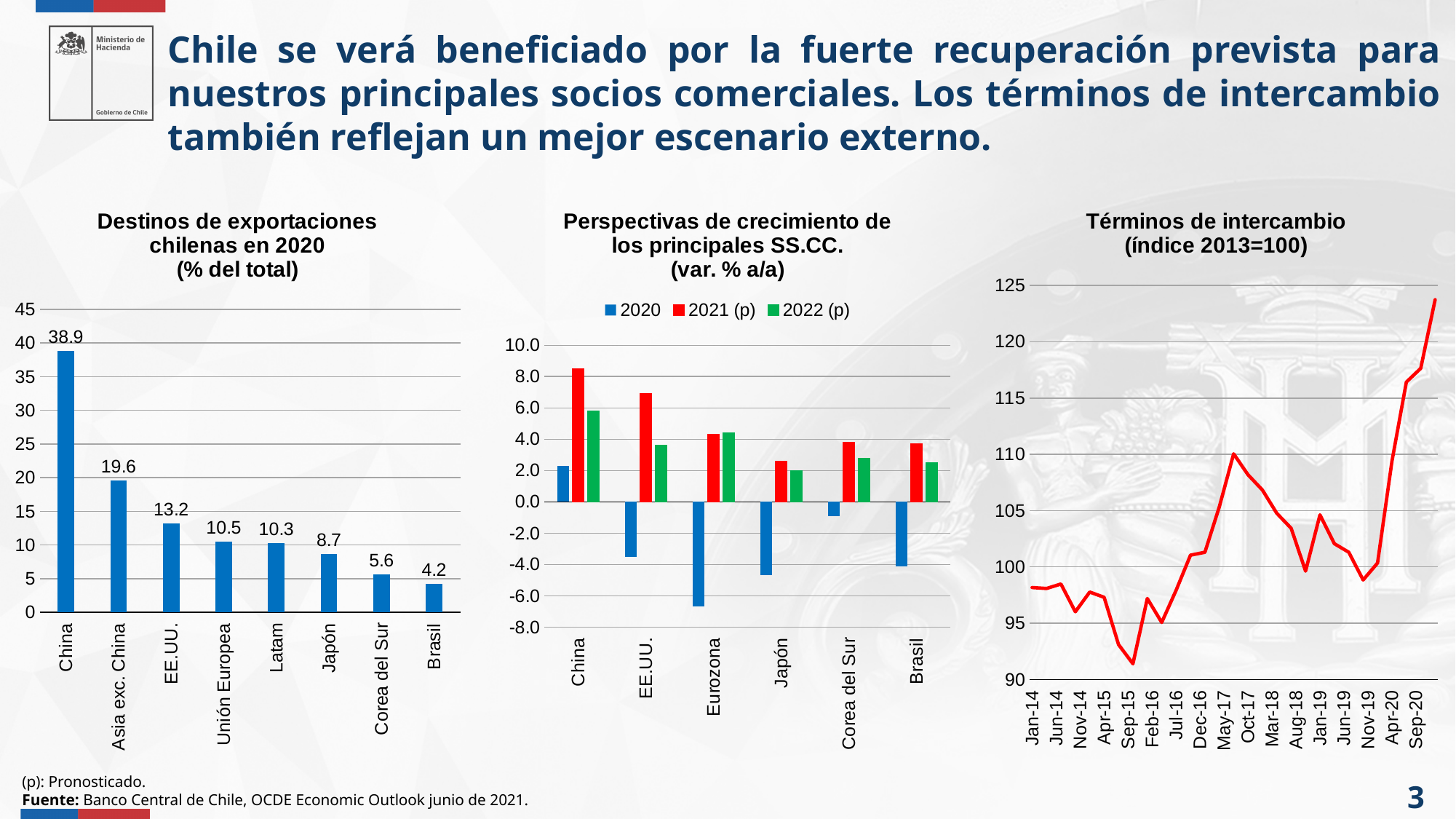
In the 'Perspectivas de crecimiento de los principales SS.CC.' chart, how many series does the legend list? 3 In the 'Destinos de exportaciones chilenas en 2020' chart, how many categories are shown? 8 In the 'Destinos de exportaciones chilenas en 2020' chart, what is the value for China? 38.9 In the 'Destinos de exportaciones chilenas en 2020' chart, which category has the lowest value? Brasil In the 'Destinos de exportaciones chilenas en 2020' chart, which is larger, the value for EE.UU. or the value for Latam? EE.UU. In the 'Perspectivas de crecimiento de los principales SS.CC.' chart, which category has the lowest 2020 value? Eurozona In the 'Destinos de exportaciones chilenas en 2020' chart, what is the difference between the values for China and Asia exc. China? 19.3 In the 'Términos de intercambio' chart, is the value at Sep-20 greater or less than 120? less In the 'Destinos de exportaciones chilenas en 2020' chart, what is the value for Japón? 8.7 In the 'Perspectivas de crecimiento de los principales SS.CC.' chart, is the 2020 value for Eurozona greater or less than -6.0? less What kind of chart is 'Términos de intercambio (índice 2013=100)'? line chart In the 'Perspectivas de crecimiento de los principales SS.CC.' chart, which category has the highest 2021 (p) value? China